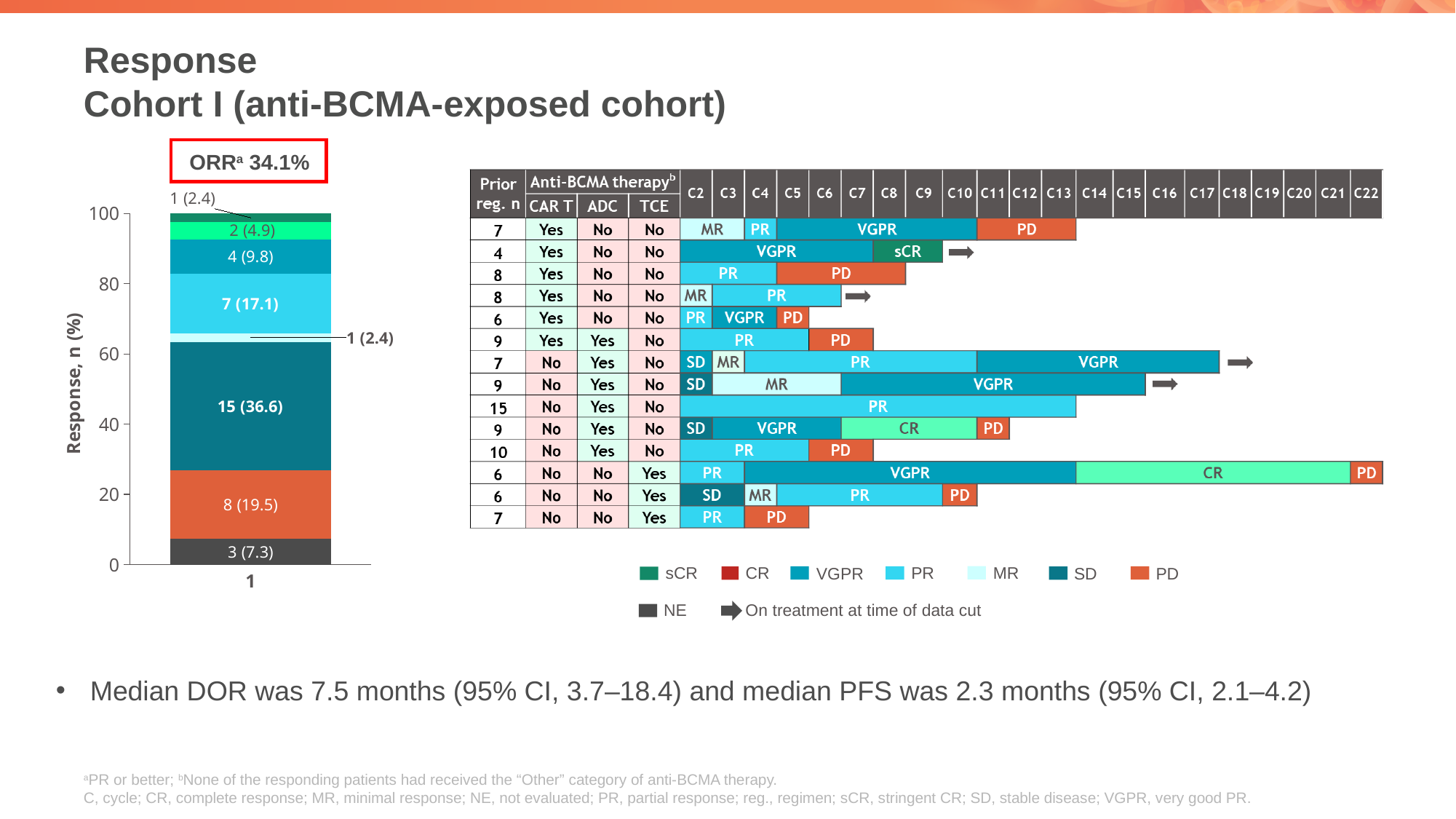
How many segments make up the stacked bar in the left chart? 8 In the stacked bar chart, what is the value of the orange segment? 8 (19.5) In the stacked bar chart, which segment is larger: the orange segment (8 (19.5)) or the light blue segment (7 (17.1))? the orange segment (8 (19.5)) In the stacked bar chart, what is the value of the light blue segment labelled in bold? 7 (17.1) In the stacked bar chart, what is the value of the bottom (dark grey) segment? 3 (7.3) In the stacked bar chart, what is the difference in patient count between the largest segment (15) and the orange segment (8)? 7 How many response categories does the legend below the swimmer plot list (excluding the arrow)? 8 In the stacked bar chart, what is the value of the largest segment? 15 (36.6) What kind of chart is shown on the left of the slide? stacked bar chart How many patient rows are shown in the swimmer plot on the right? 14 What ORR value is shown in the red box above the stacked bar chart? 34.1% In the swimmer plot, how many patients have an arrow indicating they were on treatment at the time of data cut? 4